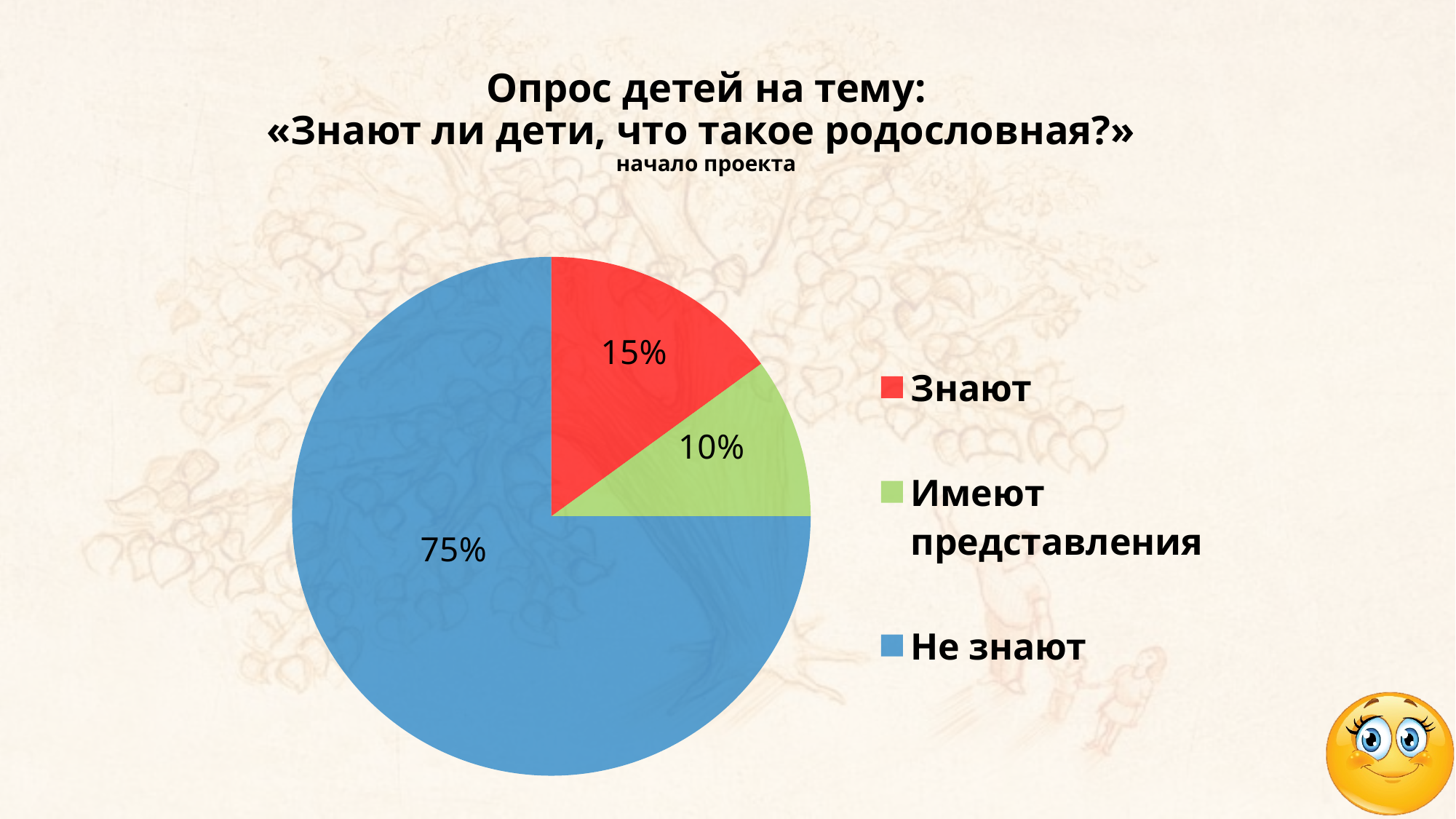
What is the difference between the «Не знают» and «Знают» percentages? 60% What percentage is shown for «Не знают»? 75% What is the title of the chart on the slide? Опрос детей на тему: «Знают ли дети, что такое родословная?» What kind of chart is shown on the slide? pie chart Which category has the largest slice of the pie? Не знают What percentage is shown for «Имеют представления»? 10% What percentage is shown for «Знают»? 15% How many categories does the pie chart have? 3 Which category has the smallest slice of the pie? Имеют представления What is the difference between the «Знают» and «Имеют представления» percentages? 5% Which is larger, the slice for «Знают» or the slice for «Имеют представления»? Знают What colour is the slice for «Не знают»? blue